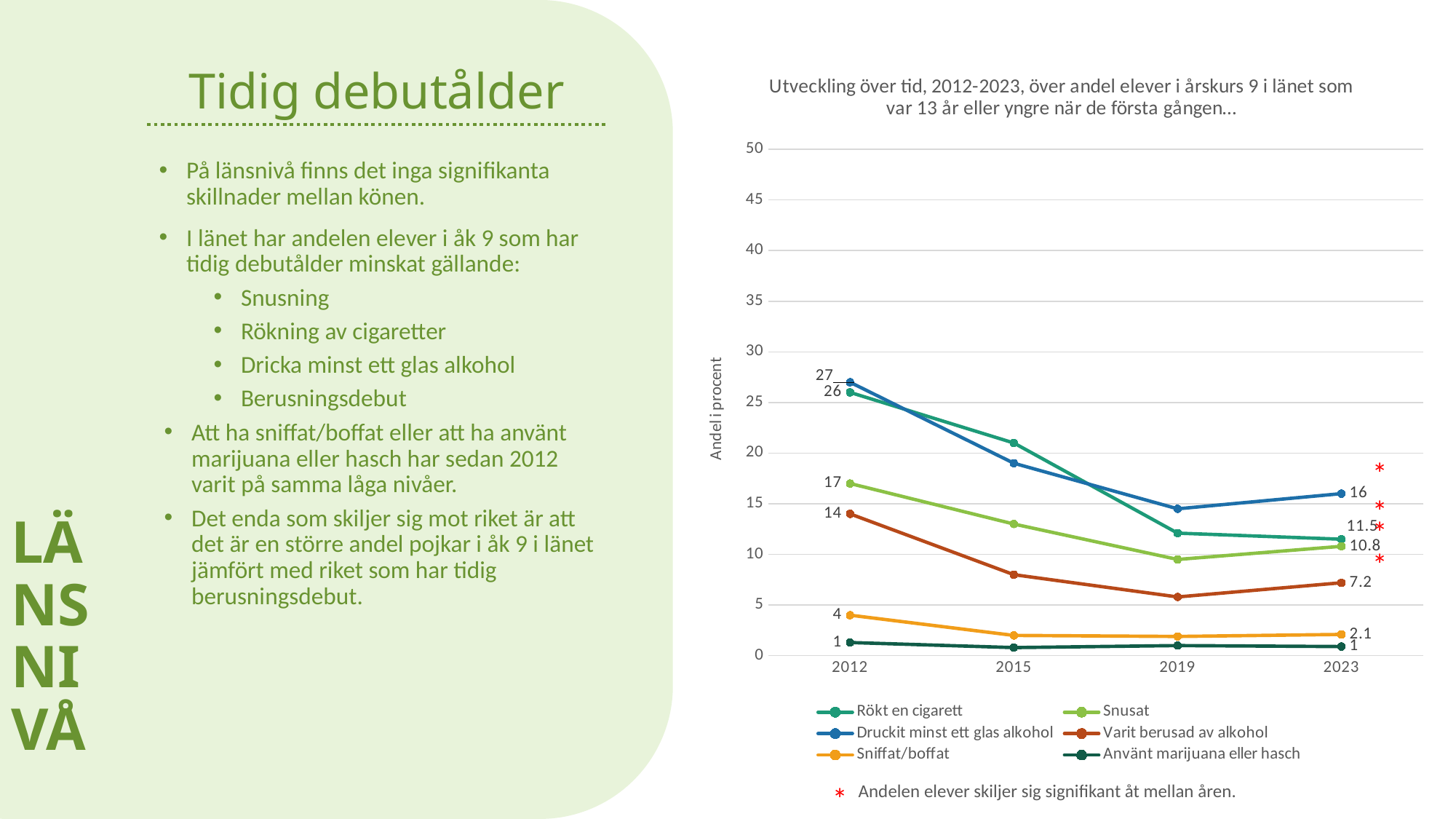
Which series has the highest value in 2012? Druckit minst ett glas alkohol What is the value for 'Rökt en cigarett' in 2012? 26 What is the value for 'Sniffat/boffat' in 2012? 4 Is the value for 'Snusat' in 2015 greater or less than 10? greater What is the value for 'Varit berusad av alkohol' in 2023? 7.2 How many years are shown on the x axis? 4 What is the value for 'Druckit minst ett glas alkohol' in 2012? 27 How many series does the legend list? 6 What kind of chart is shown on the slide? line chart What is the value for 'Snusat' in 2023? 10.8 By how much did the value for 'Druckit minst ett glas alkohol' fall from 2012 (27) to 2023 (16)? 11 Does the value for 'Varit berusad av alkohol' rise or fall from 2012 to 2019? fall